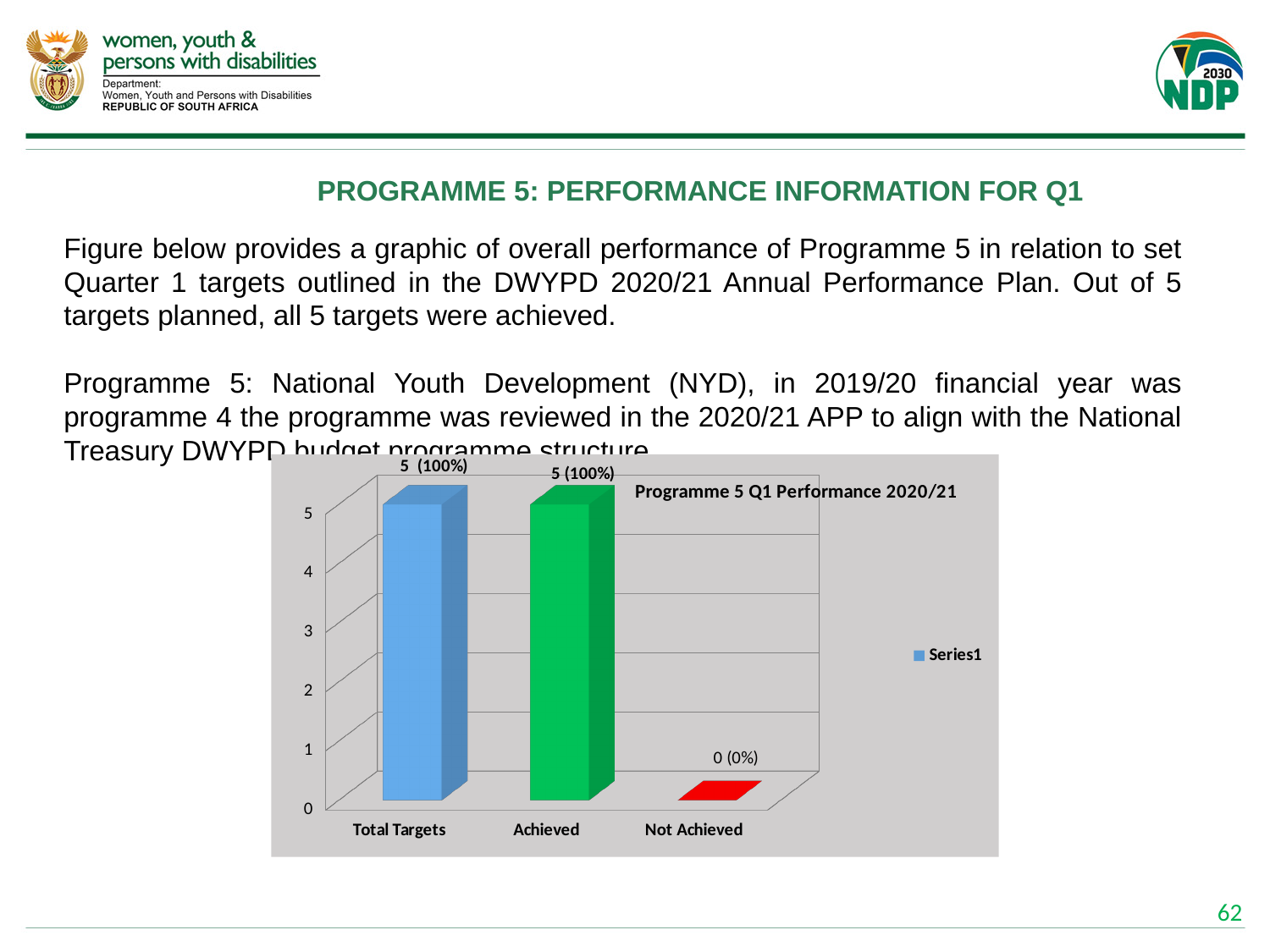
What is the difference between the Achieved and Not Achieved values? 5 Is the value for Total Targets greater or less than 3? greater What kind of chart is shown? Bar chart What is the legend entry shown on the chart? Series1 What is the value shown for Achieved? 5 (100%) How many categories are shown on the x axis? 3 Which is larger, the value for Achieved or the value for Not Achieved? Achieved What is the value shown for Total Targets? 5 (100%) Which category has the lowest value? Not Achieved What is the value shown for Not Achieved? 0 (0%) What is the title of the chart? Programme 5 Q1 Performance 2020/21 How many series does the legend list? 1